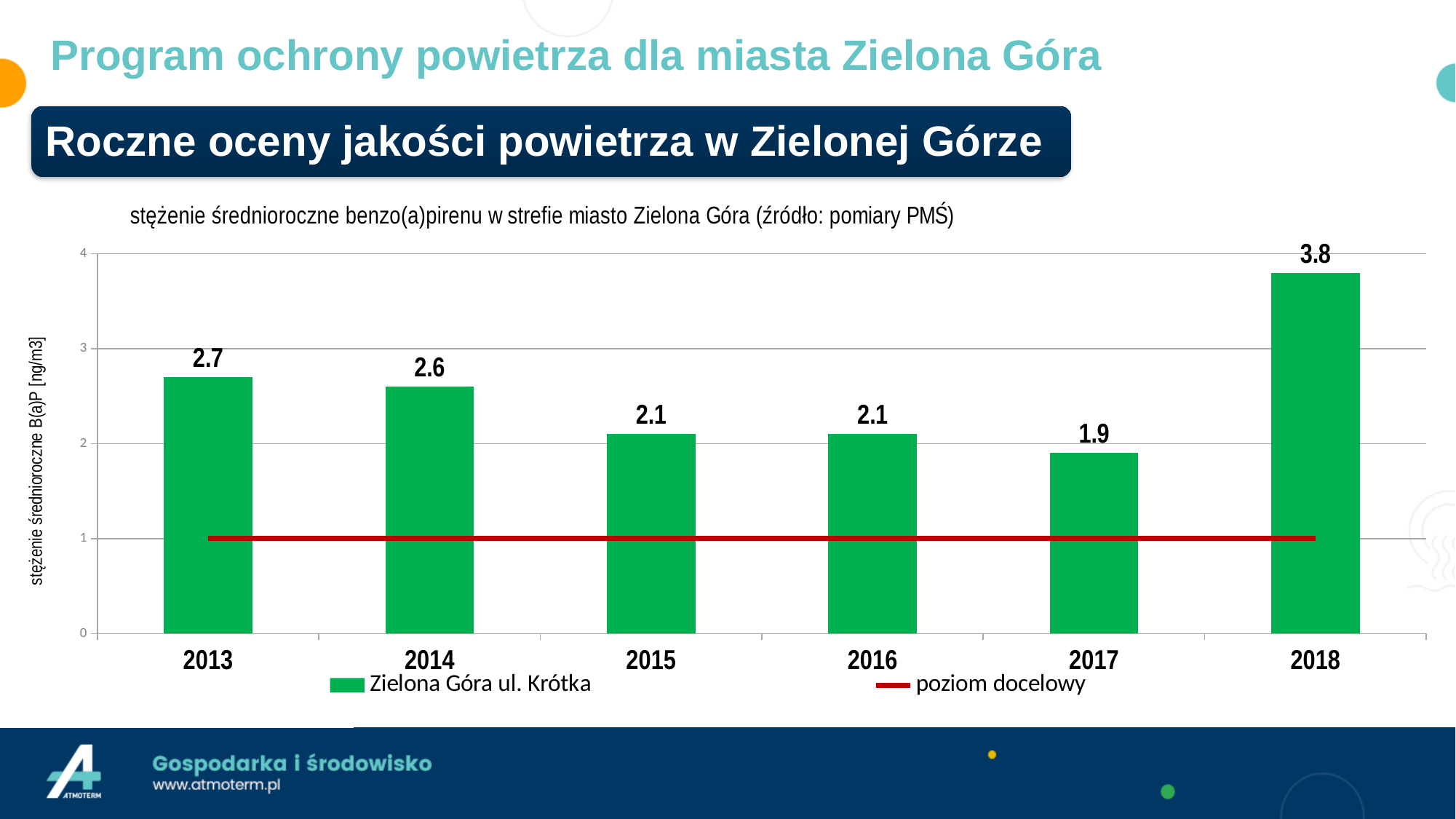
Which is larger, the value for 2013 or the value for 2014? 2013 What is the label of the red line in the legend? poziom docelowy Which year has the lowest value? 2017 What is the value for 2013? 2.7 What is the difference between the values for 2018 and 2017? 1.9 How many entries does the legend list? 2 Which year has the highest value? 2018 What is the value for 2017? 1.9 What kind of chart is this? bar chart What is the value for 2018? 3.8 How many years are shown on the x axis? 6 Is the value for 2016 greater or less than 3? less